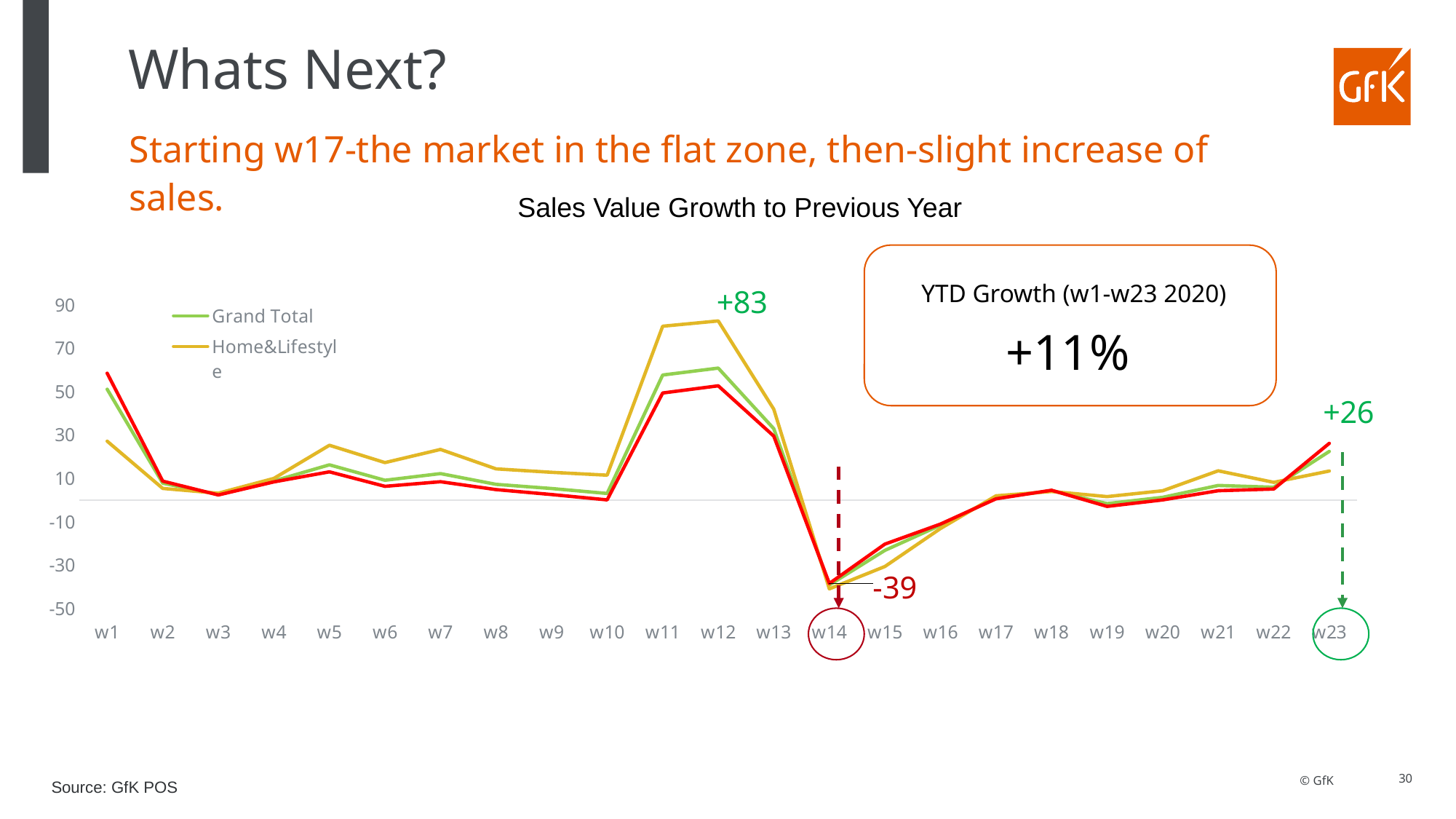
How many series does the chart legend list? 2 What kind of chart is shown on the slide? line chart Is the Home&Lifestyle value at w11 greater or less than 70? greater What YTD Growth (w1-w23 2020) figure is shown in the box on the slide? +11% How many weeks are plotted along the x axis of the chart? 23 What value is labelled on the chart at w14? -39 What is the title of the chart? Sales Value Growth to Previous Year In which week does the Home&Lifestyle line reach its highest value? w12 What value is labelled on the chart at w23? +26 What peak value is labelled on the chart at w12? +83 In which week do the lines reach their lowest value? w14 At w11, which series is higher: Home&Lifestyle or Grand Total? Home&Lifestyle